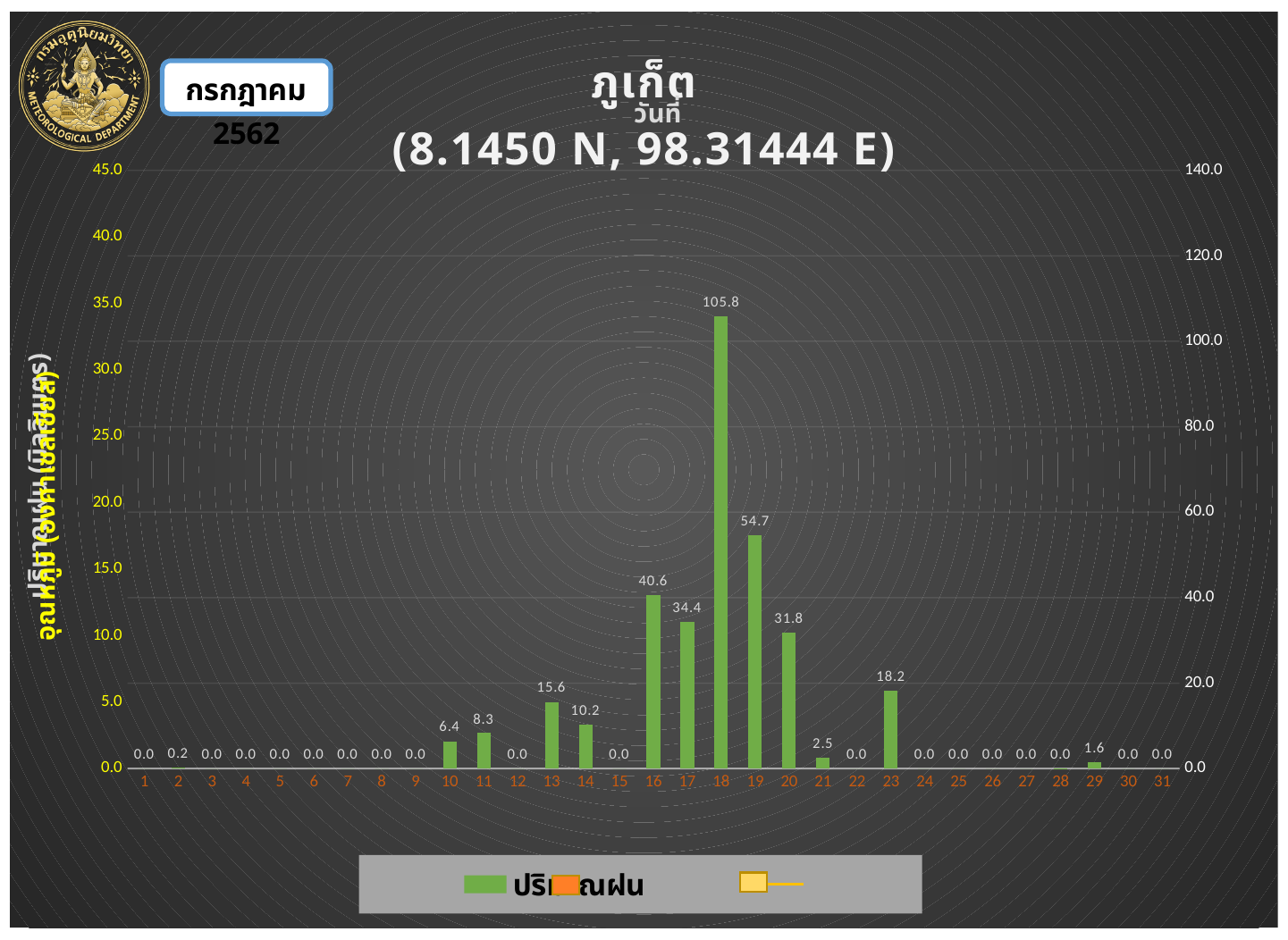
What is the rainfall value shown for day 18? 105.8 What is the rainfall value shown for day 16? 40.6 Which day has the highest rainfall value? 18 Which is larger, the rainfall value for day 20 or for day 23? day 20 What location name appears in the chart title? ภูเก็ต What is the rainfall value shown for day 23? 18.2 What is the difference between the rainfall values for day 16 and day 17? 6.2 What is the rainfall value shown for day 11? 8.3 What is the difference between the rainfall values for day 18 and day 19? 51.1 Which is larger, the rainfall value for day 13 or for day 14? day 13 How many days are shown on the x axis? 31 What kind of chart is this? bar chart